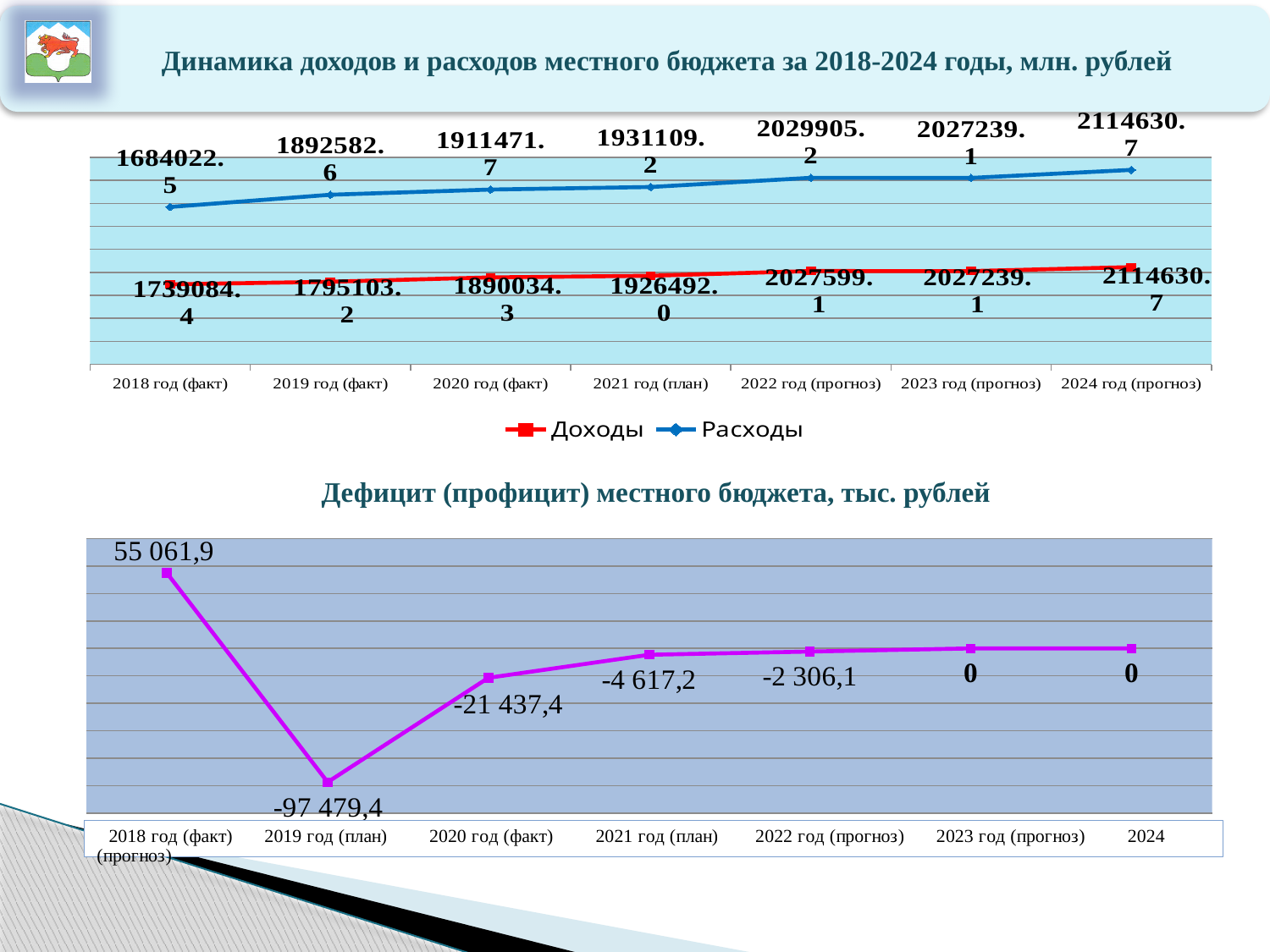
In the bottom chart (Дефицит (профицит) местного бюджета), which category has the lowest value? 2019 год (план) In the top chart (Динамика доходов и расходов местного бюджета), what is the value of Доходы for 2021 год (план)? 1926492.0 In the top chart (Динамика доходов и расходов местного бюджета), what is the value of Расходы for 2018 год (факт)? 1684022.5 In the top chart (Динамика доходов и расходов местного бюджета), what is the value of Расходы for 2022 год (прогноз)? 2029905.2 In the top chart (Динамика доходов и расходов местного бюджета), how many series does the legend list? 2 In the bottom chart (Дефицит (профицит) местного бюджета), which category has the highest value? 2018 год (факт) In the top chart (Динамика доходов и расходов местного бюджета), what kind of chart is it? Line chart In the bottom chart (Дефицит (профицит) местного бюджета), what is the value for 2018 год (факт)? 55 061,9 In the top chart (Динамика доходов и расходов местного бюджета), what is the value of Доходы for 2018 год (факт)? 1739084.4 In the bottom chart (Дефицит (профицит) местного бюджета), how many data points are plotted? 7 In the bottom chart (Дефицит (профицит) местного бюджета), what is the value for 2019 год (план)? -97 479,4 In the top chart (Динамика доходов и расходов местного бюджета), which colour is used for the Доходы series? Red